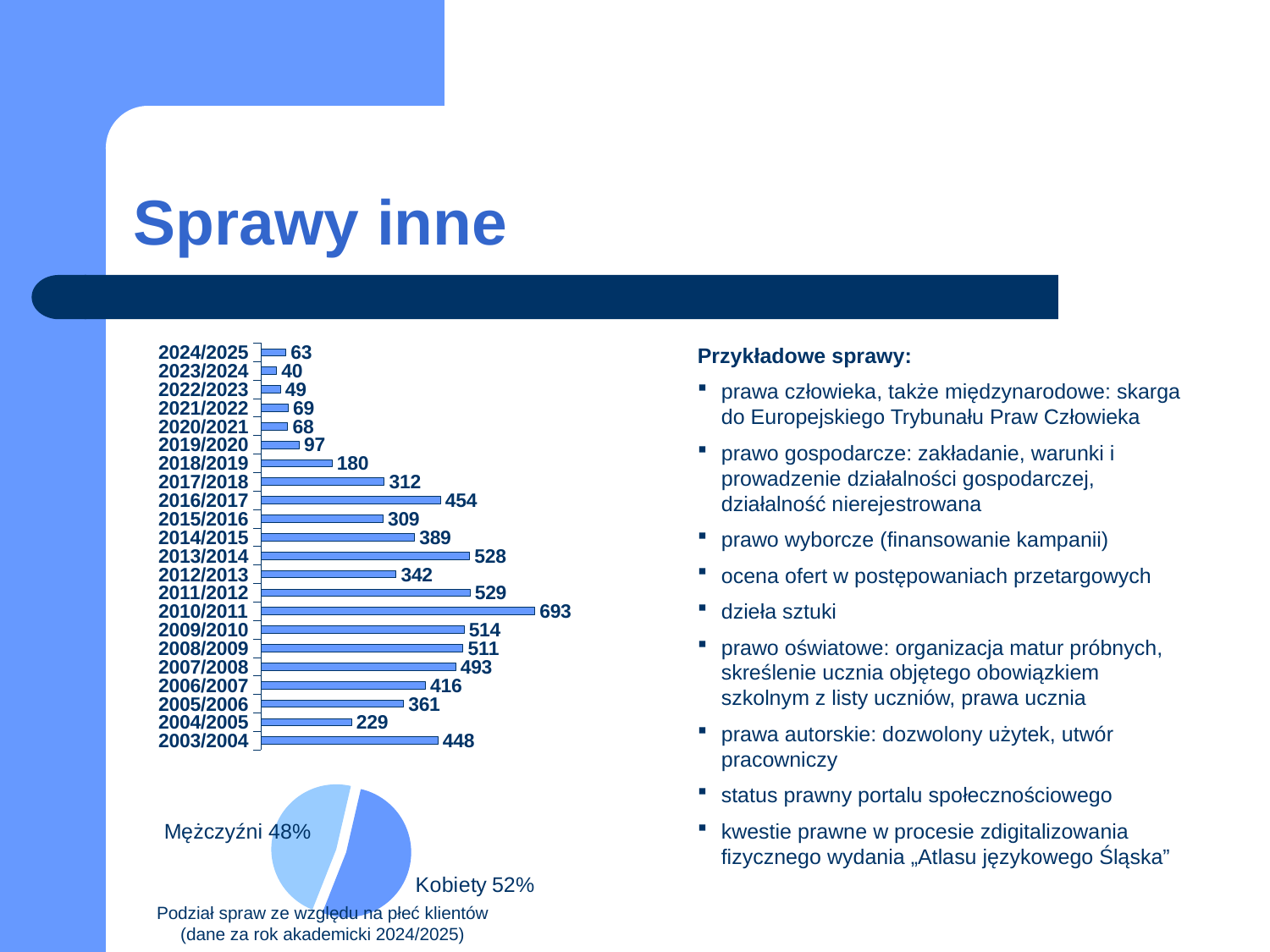
In the bar chart on the left, which academic year has the lowest value? 2023/2024 In the bar chart on the left, what is the value for 2024/2025? 63 What kind of chart is the chart on the left showing values by academic year? Bar chart In the bar chart on the left, what is the value for 2003/2004? 448 In the pie chart titled 'Podział spraw ze względu na płeć klientów', which academic year does the data refer to? 2024/2025 In the bar chart on the left, what is the difference between the values for 2011/2012 and 2012/2013? 187 In the bar chart on the left, what is the value for 2010/2011? 693 In the bar chart on the left, which academic year has the highest value? 2010/2011 In the pie chart titled 'Podział spraw ze względu na płeć klientów', what share is Kobiety? 52% In the pie chart titled 'Podział spraw ze względu na płeć klientów', what share is Mężczyźni? 48% In the bar chart on the left, which is larger, the value for 2016/2017 or the value for 2017/2018? 2016/2017 How many academic years are shown in the bar chart on the left? 22